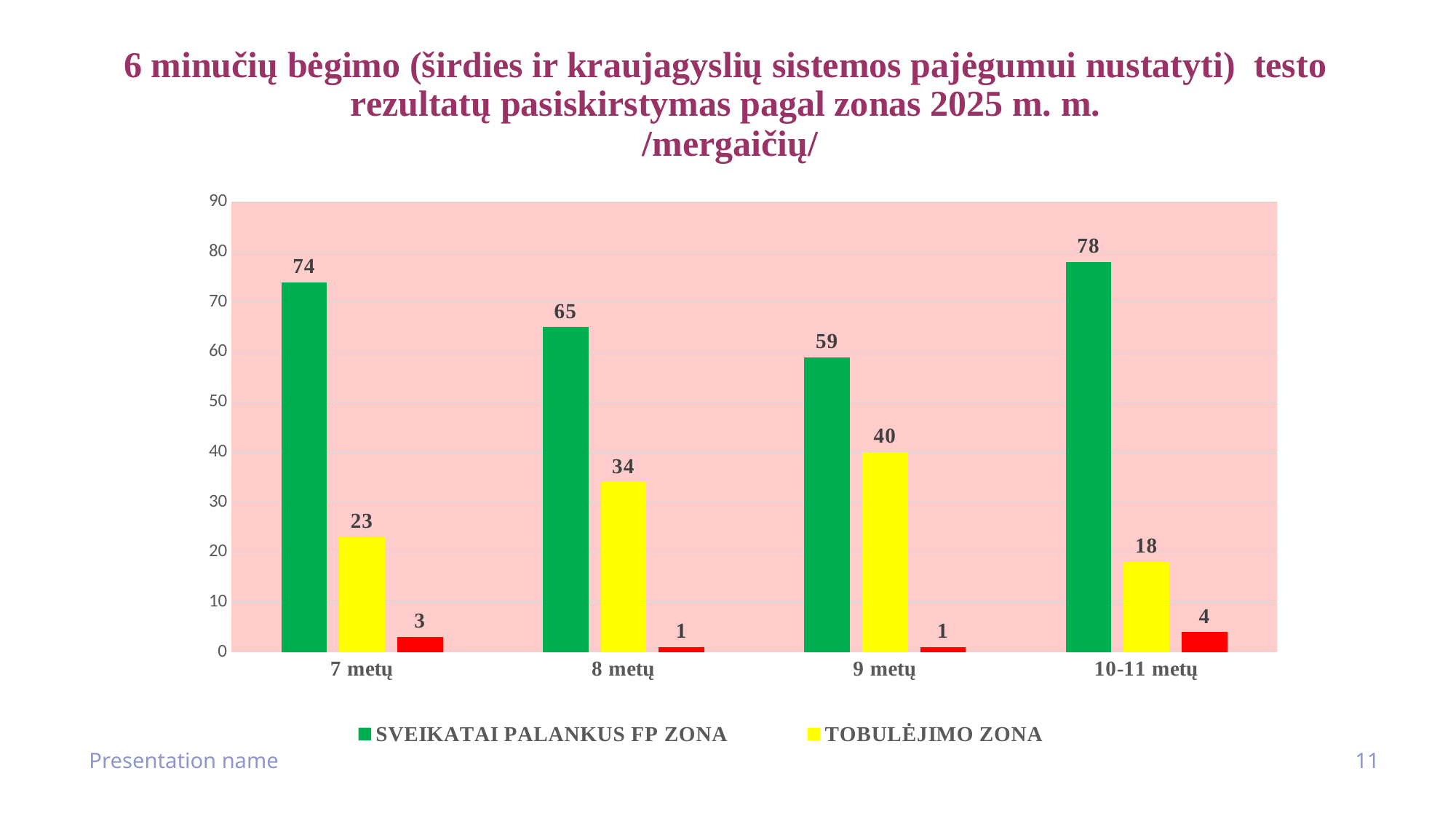
What is the value for TOBULĖJIMO ZONA in the 10-11 metų group? 18 Which is larger: the TOBULĖJIMO ZONA value for 8 metų or for 7 metų? 8 metų How many series does the legend list? 2 What is the value for SVEIKATAI PALANKUS FP ZONA in the 7 metų group? 74 What is the value for TOBULĖJIMO ZONA in the 9 metų group? 40 What colour are the bars for TOBULĖJIMO ZONA? yellow How many age groups are shown on the x axis? 4 What is the value for SVEIKATAI PALANKUS FP ZONA in the 8 metų group? 65 What kind of chart is shown on the slide? bar chart Which age group has the highest value for SVEIKATAI PALANKUS FP ZONA? 10-11 metų Which age group has the lowest value for TOBULĖJIMO ZONA? 10-11 metų What is the difference between the SVEIKATAI PALANKUS FP ZONA values for 10-11 metų and 9 metų? 19